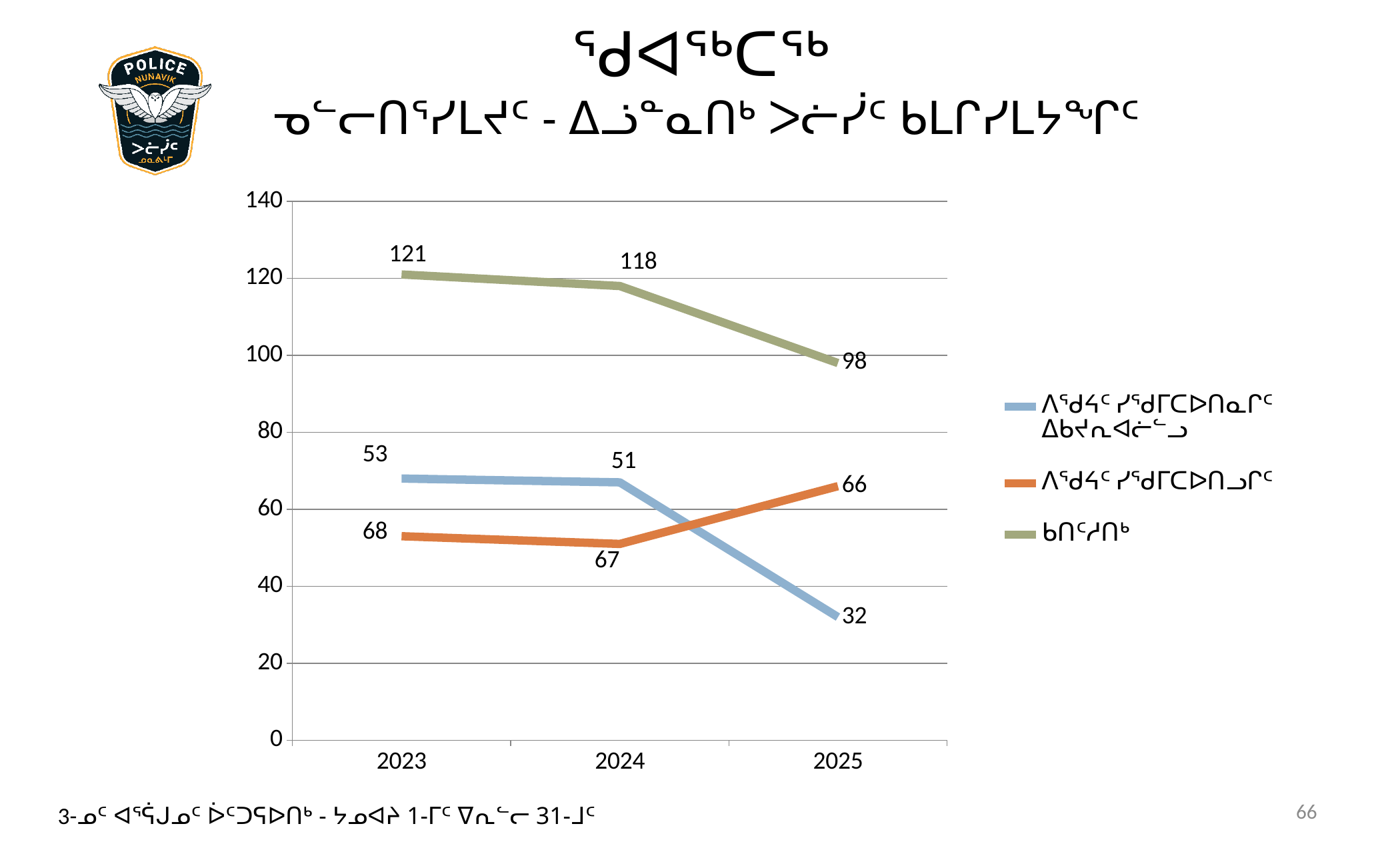
How many years are shown on the x axis? 3 Does the green line rise or fall from 2023 to 2025? fall What is the value of the orange line in 2025? 66 What is the value of the blue line in 2025? 32 What is the difference between the green line's 2023 value and its 2025 value? 23 What is the value of the green line in 2025? 98 What kind of chart is shown on the slide? line chart In which year is the green line at its highest? 2023 In 2025, which is larger: the orange line or the blue line? orange line How many series does the legend list? 3 What is the value of the green line in 2023? 121 What is the value of the green line in 2024? 118